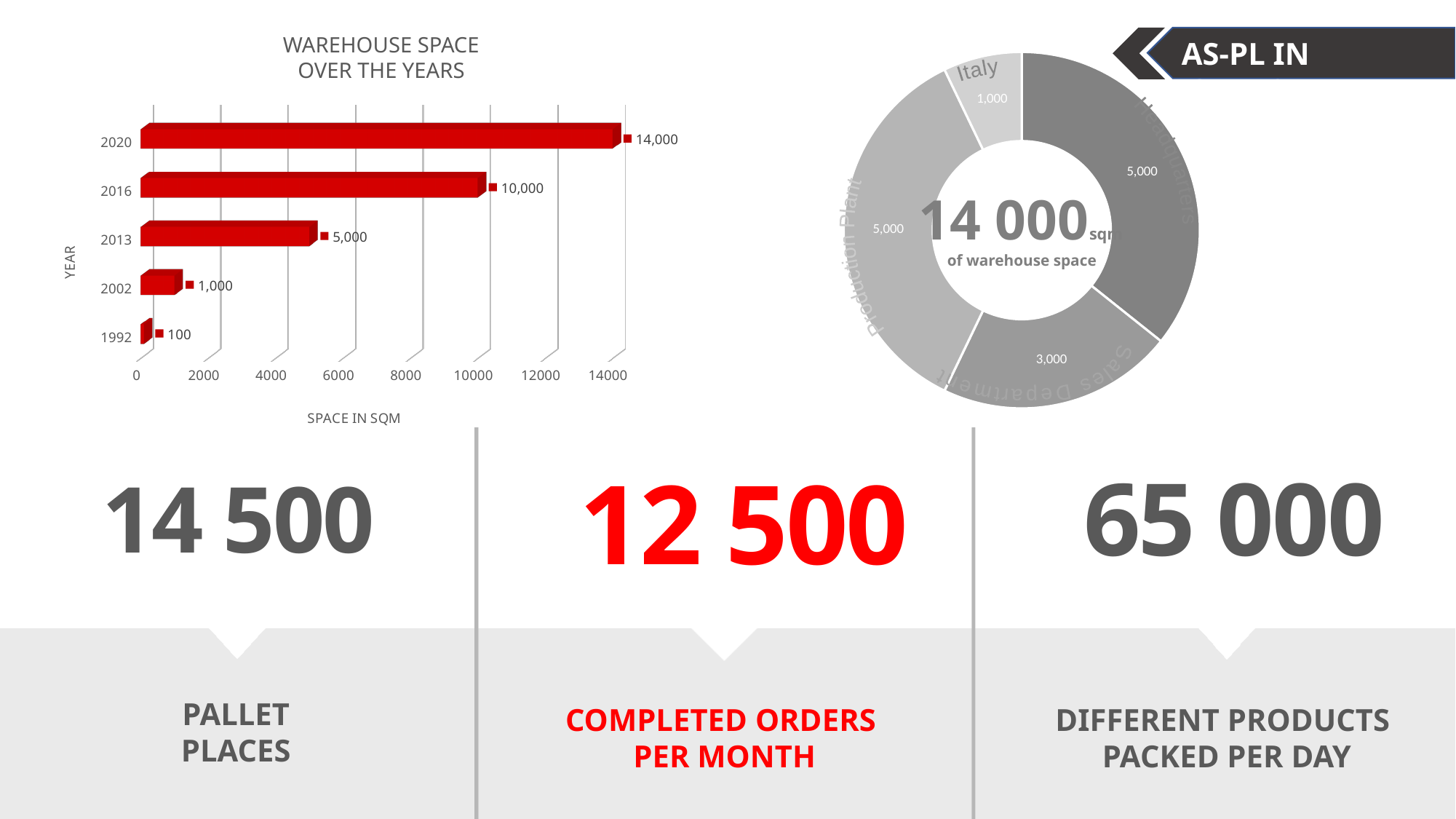
In the bar chart 'Warehouse space over the years', how many years are shown? 5 In the bar chart 'Warehouse space over the years', what is the warehouse space for 1992? 100 What type of chart is 'Warehouse space over the years'? Bar chart In the bar chart 'Warehouse space over the years', what is the warehouse space for 2020? 14,000 In the bar chart 'Warehouse space over the years', how much larger is the warehouse space in 2020 than in 2016? 4,000 In the donut chart on the right, what is the difference between the Production Plant value and the Italy value? 4,000 In the bar chart 'Warehouse space over the years', which year has the smallest warehouse space? 1992 In the donut chart on the right, what value is shown for Italy? 1,000 In the bar chart 'Warehouse space over the years', which year has the largest warehouse space? 2020 In the donut chart on the right, what value is shown for Sales Department? 3,000 In the bar chart 'Warehouse space over the years', what is the warehouse space for 2013? 5,000 In the bar chart 'Warehouse space over the years', what is the label of the horizontal axis? SPACE IN SQM